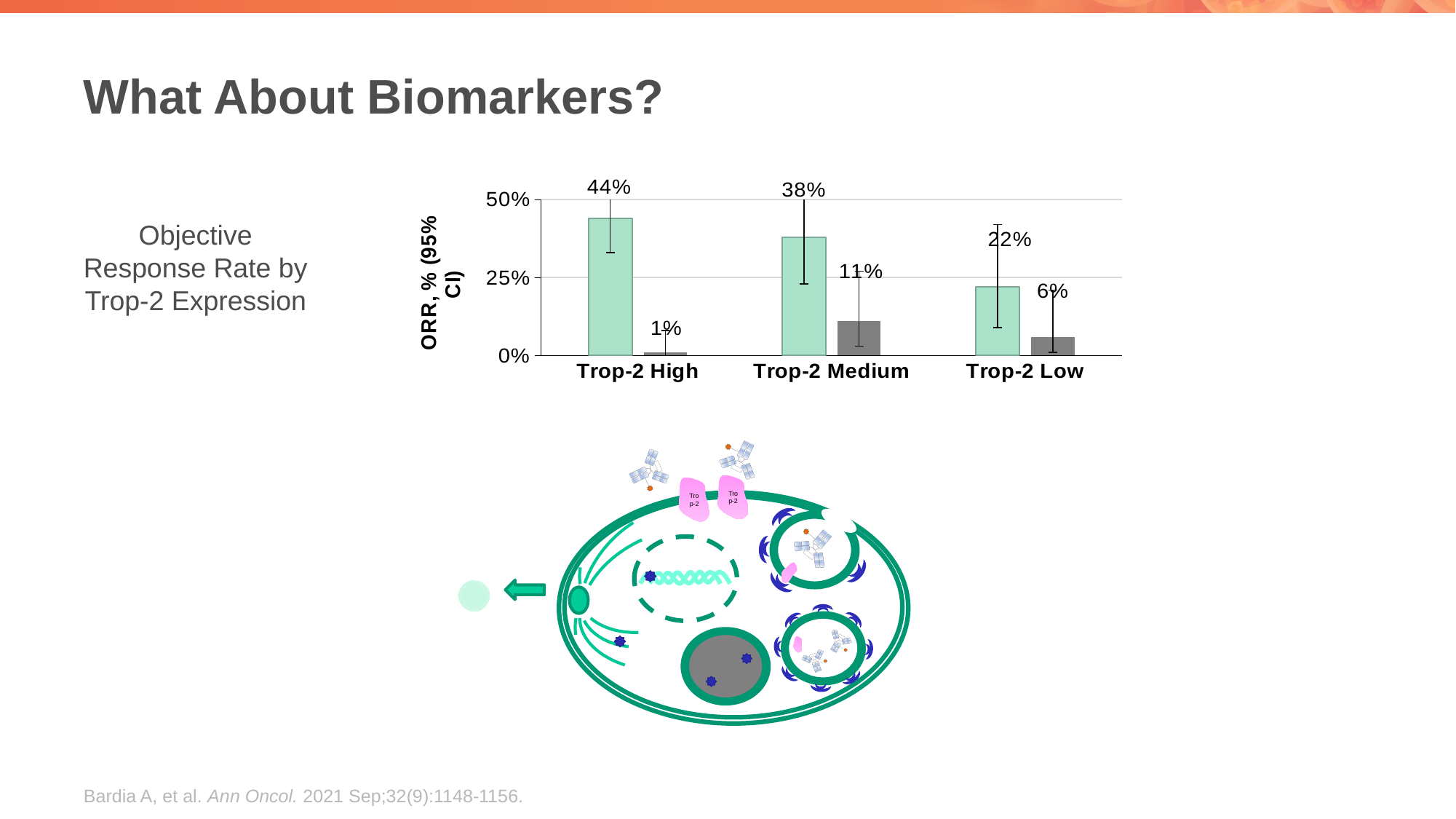
What is the value of the green bar for Trop-2 Low? 22% Which category has the highest green bar? Trop-2 High Which category has the lowest gray bar? Trop-2 High What is the label of the y axis? ORR, % (95% CI) What is the value of the gray bar for Trop-2 Medium? 11% How many categories are shown on the x axis? 3 Do the green bars rise or fall from Trop-2 High to Trop-2 Low? Fall Which is larger: the green bar for Trop-2 Medium or the green bar for Trop-2 Low? Trop-2 Medium What kind of chart is shown on the slide? Bar chart What is the value of the gray bar for Trop-2 Low? 6% What is the value of the green bar for Trop-2 High? 44% What is the difference between the green and gray bars for Trop-2 Medium? 27%